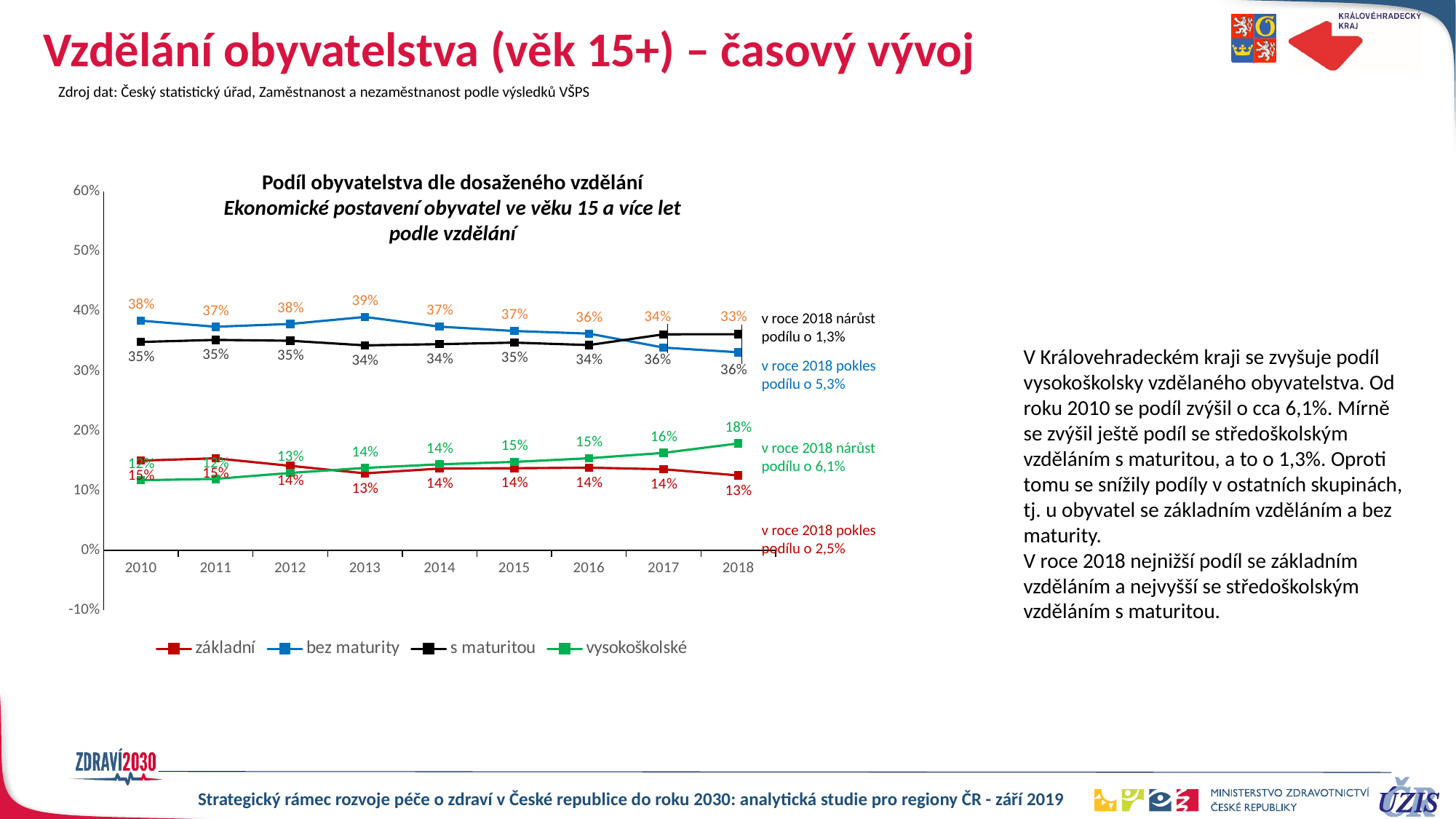
What is the value for s maturitou in 2017? 36% In 2018, which is larger: bez maturity or s maturitou? s maturitou What is the value for vysokoškolské in 2018? 18% Is the value for bez maturity in 2018 greater or less than 30%? greater How many years are plotted along the x axis of the chart? 9 By how many percentage points did the value for bez maturity fall from 2010 to 2018? 5 percentage points In which year is the value for bez maturity the highest? 2013 How many series does the chart legend list? 4 What is the value for bez maturity in 2013? 39% Does the value for vysokoškolské rise or fall from 2010 to 2018? rise What is the value for základní in 2018? 13% What kind of chart is shown on the slide? line chart